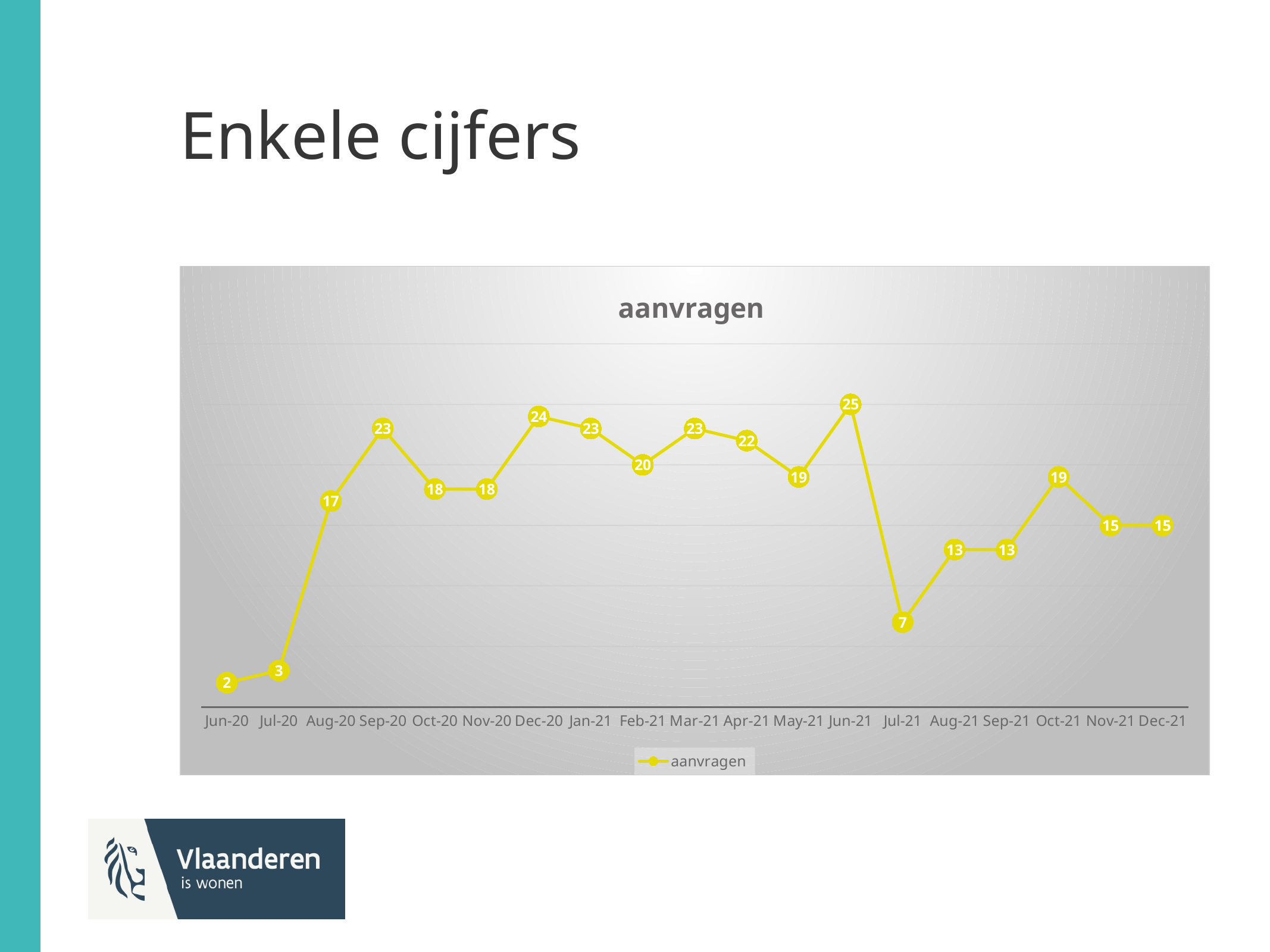
What is the value for Dec-20? 24 How many series does the legend list? 1 What is the value for Aug-20? 17 How many data points are plotted on the chart? 19 What is the value for Jun-21? 25 Which month has the highest value? Jun-21 Which is larger, the value for Sep-20 or the value for Oct-20? Sep-20 What is the difference between the values for Jun-21 and Jul-21? 18 What is the value for Jul-21? 7 What type of chart is shown on the slide? line chart Which month has the lowest value? Jun-20 What is the title of the chart? aanvragen